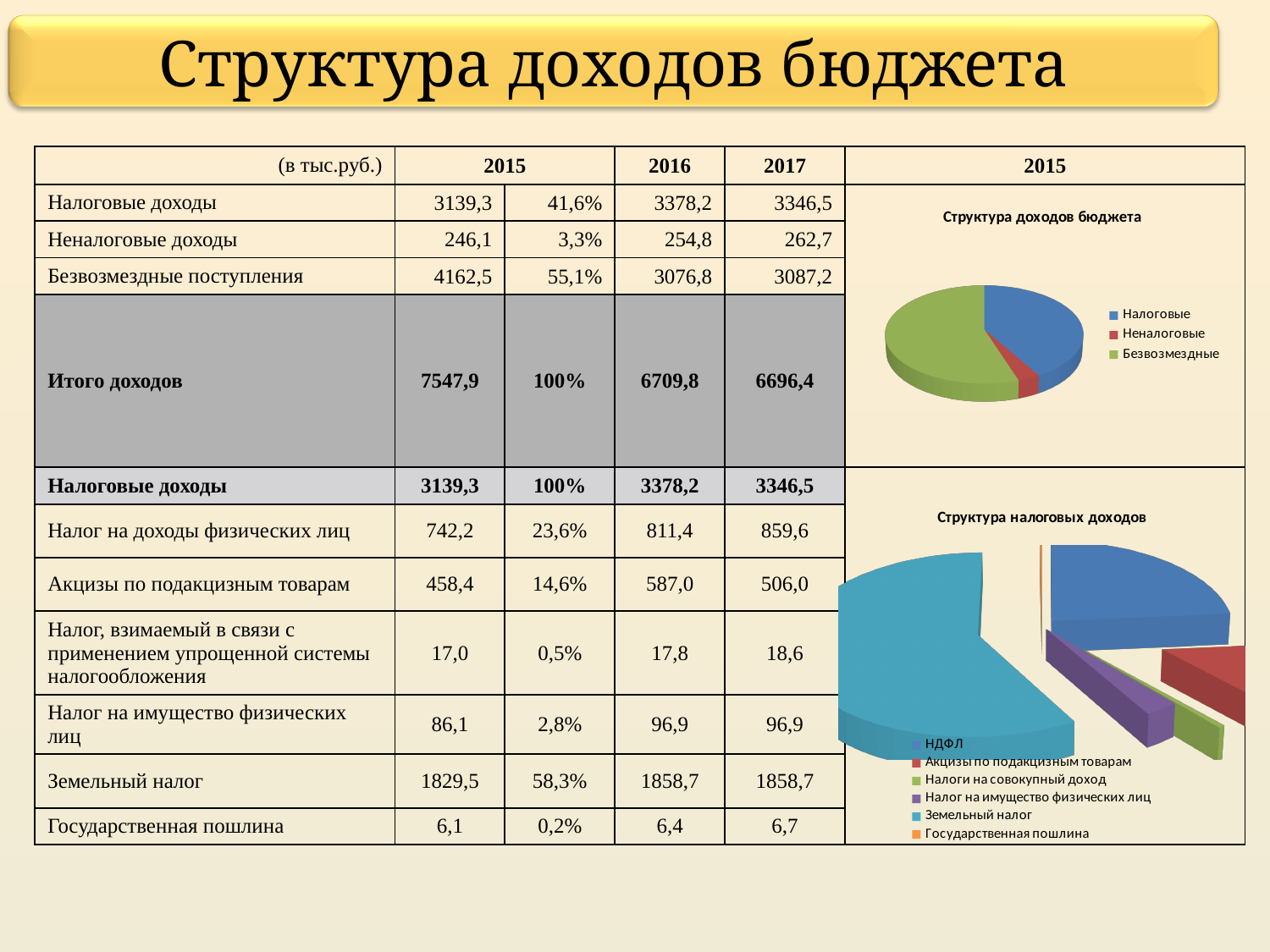
In the chart titled "Структура доходов бюджета", which slice is larger: Налоговые or Неналоговые? Налоговые What kind of chart is the chart titled "Структура налоговых доходов"? pie chart In the chart titled "Структура налоговых доходов", what share of the pie does Земельный налог make up according to the table? 58,3% In the chart titled "Структура доходов бюджета", how many entries does the legend list? 3 In the chart titled "Структура налоговых доходов", which category has the largest slice? Земельный налог In the chart titled "Структура доходов бюджета", what colour is the Безвозмездные slice? green In the chart titled "Структура доходов бюджета", what share of the pie do Безвозмездные поступления make up according to the table? 55,1% In the chart titled "Структура доходов бюджета", which category has the smallest slice? Неналоговые What kind of chart is the chart titled "Структура доходов бюджета"? pie chart In the chart titled "Структура доходов бюджета", which category has the largest slice? Безвозмездные In the chart titled "Структура налоговых доходов", which slice is larger: НДФЛ or Акцизы по подакцизным товарам? НДФЛ In the chart titled "Структура налоговых доходов", how many entries does the legend list? 6